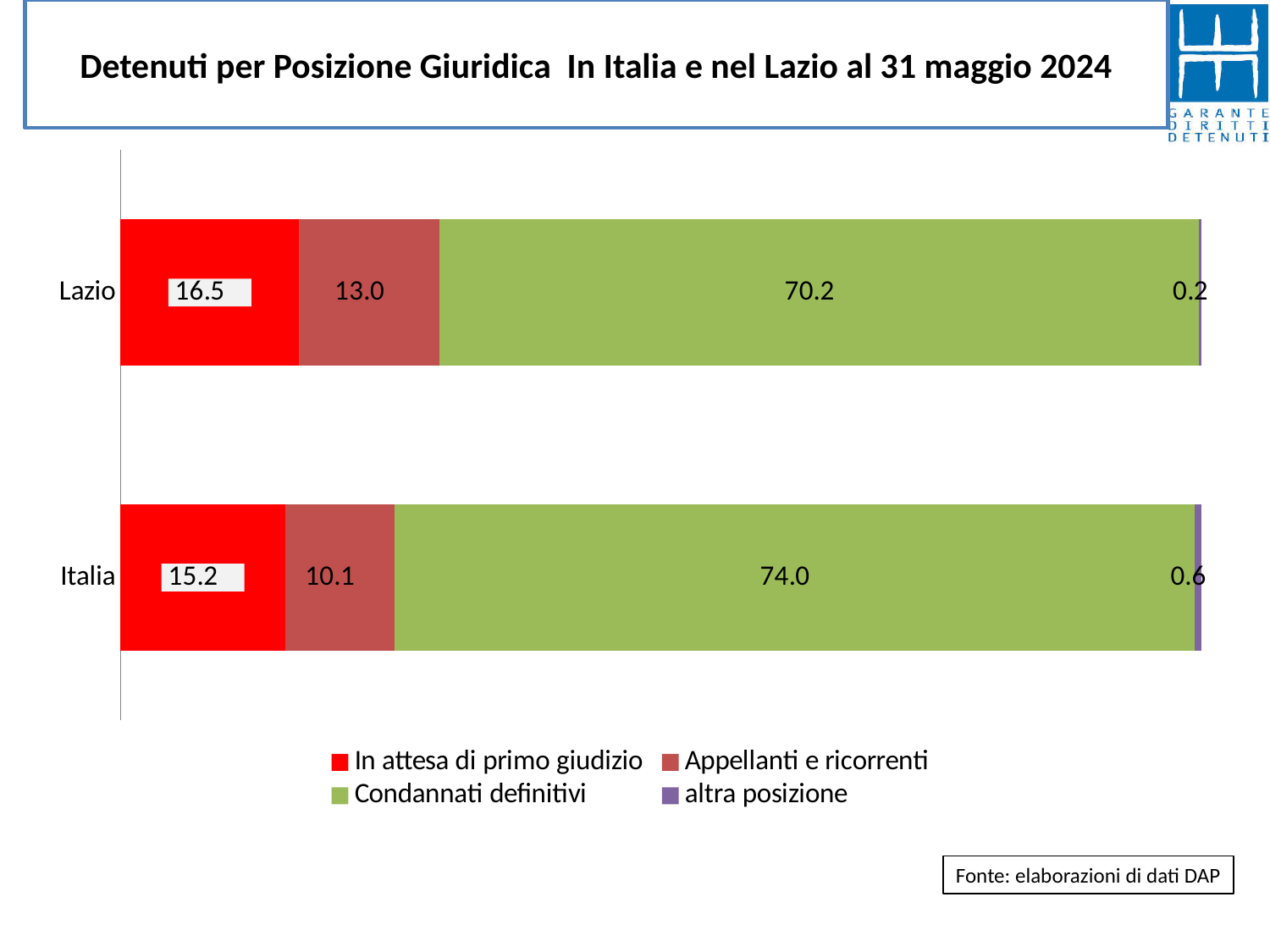
What is the value for "Appellanti e ricorrenti" for Lazio? 13.0 What is the difference between the "In attesa di primo giudizio" values for Lazio and Italia? 1.3 What is the value for "altra posizione" for Italia? 0.6 What is the title of the chart? Detenuti per Posizione Giuridica In Italia e nel Lazio al 31 maggio 2024 What kind of chart is shown on the slide? Stacked bar chart What is the value for "Condannati definitivi" for Italia? 74.0 What is the difference between the "Appellanti e ricorrenti" values for Lazio and Italia? 2.9 How many series does the legend list? 4 Which series has the largest segment in the Lazio bar? Condannati definitivi Which category has the higher value for "Condannati definitivi", Lazio or Italia? Italia How many categories are shown on the chart? 2 What is the value for "In attesa di primo giudizio" for Lazio? 16.5